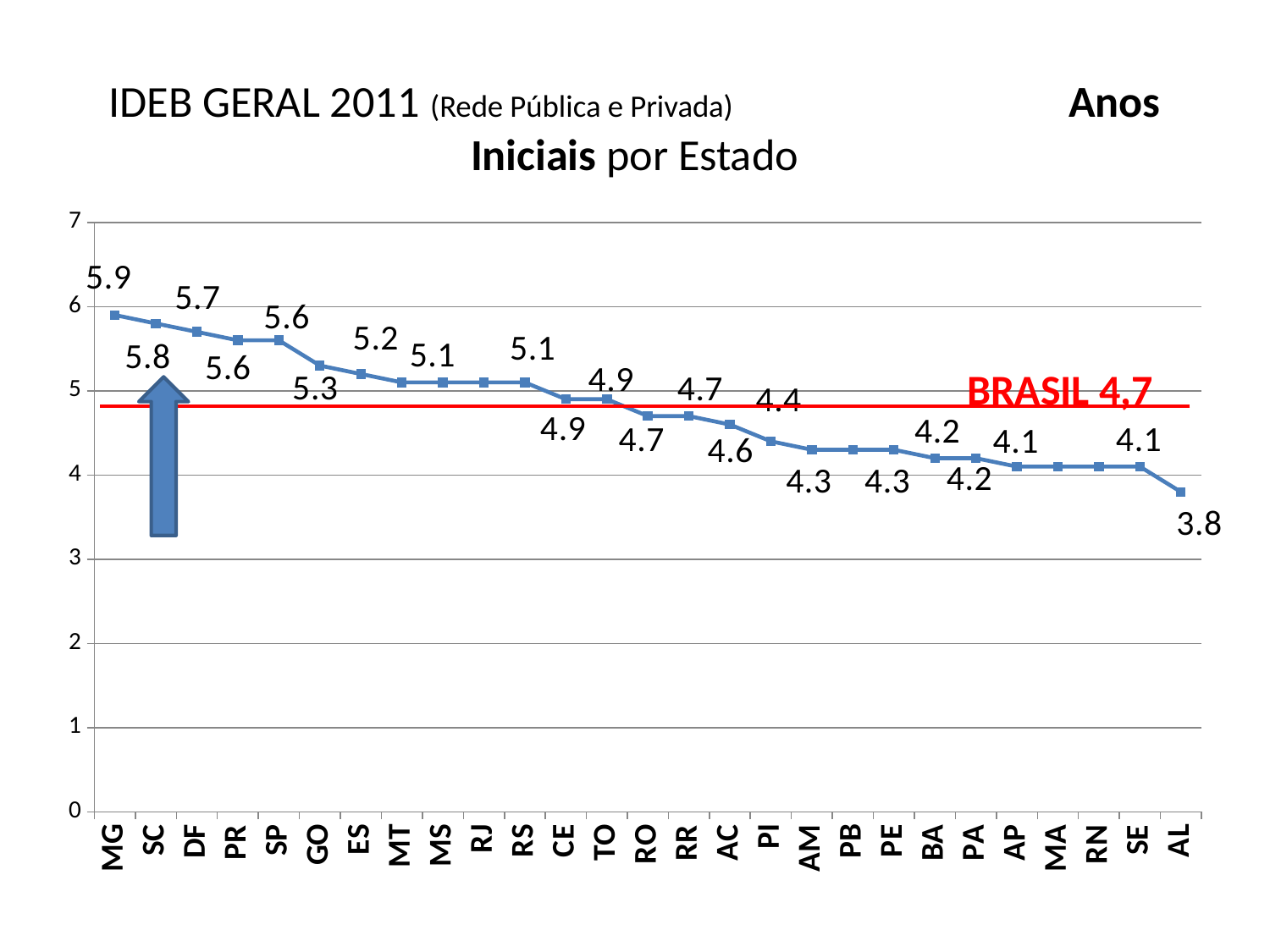
Do the values rise or fall from left to right along the x axis? Fall What is the IDEB value for AL? 3.8 What kind of chart is shown on the slide? Line chart What is the difference between the IDEB values of MG and AL? 2.1 What is the IDEB value for MG? 5.9 What is the IDEB value for GO? 5.3 How many states are plotted on the chart? 27 Which has a higher IDEB value, SC or ES? SC Which state has the lowest IDEB value? AL Which state has the highest IDEB value? MG What is the IDEB value for PI? 4.4 What value does the red horizontal reference line labelled BRASIL represent? 4,7